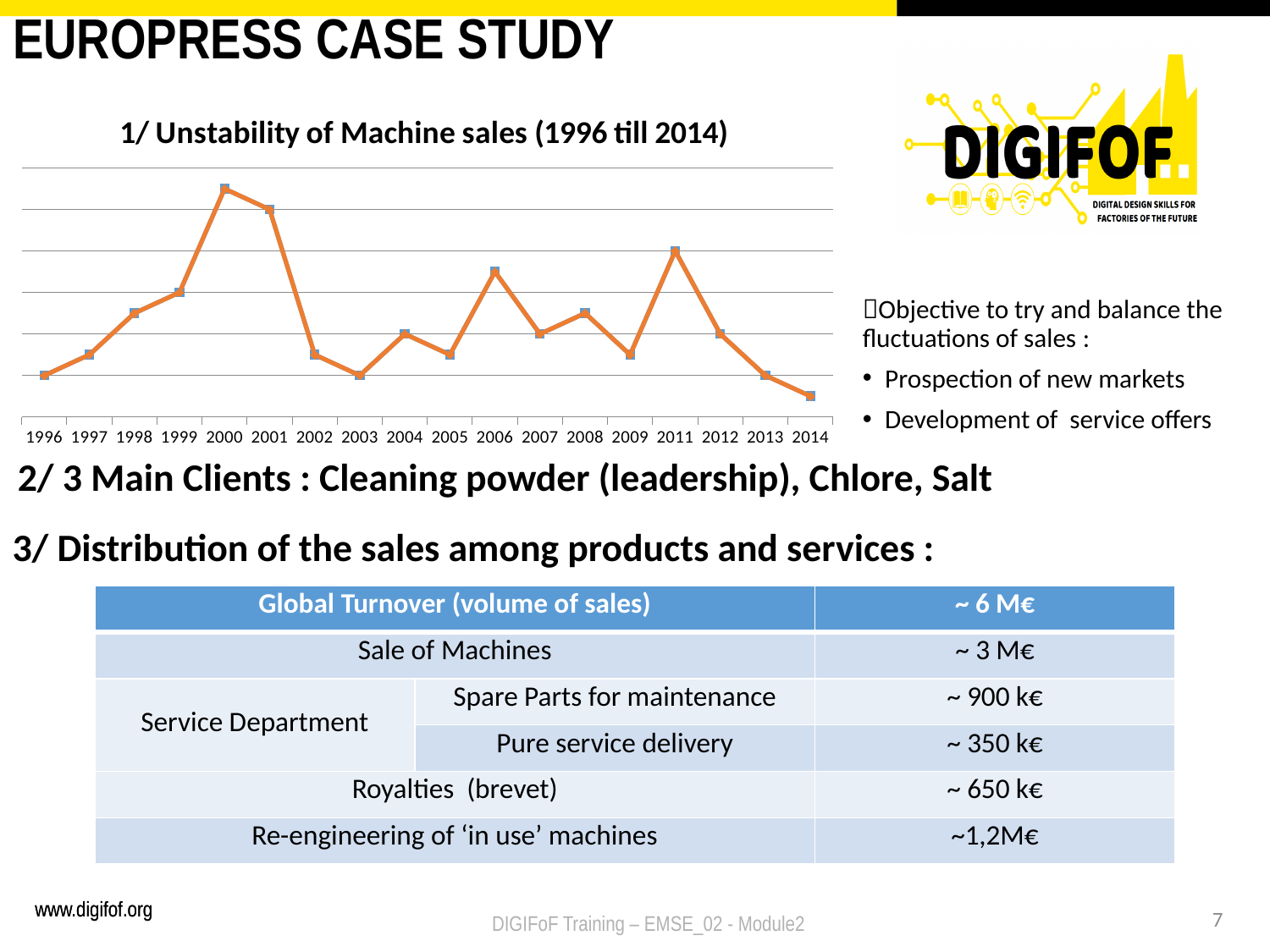
Which year has the highest machine sales in the chart? 2000 Which year has higher machine sales, 2002 or 2003? 2002 How many years are plotted on the x axis of the chart? 18 Do machine sales rise or fall from 2011 to 2014? fall What kind of chart is shown on the slide? line chart Which year has the lowest machine sales in the chart? 2014 What is the title of the chart? 1/ Unstability of Machine sales (1996 till 2014) Which year has higher machine sales, 2006 or 2011? 2011 Do machine sales rise or fall from 1996 to 2000? rise Which year has higher machine sales, 2009 or 2011? 2011 Which year between 1996 and 2014 is missing from the chart's x axis? 2010